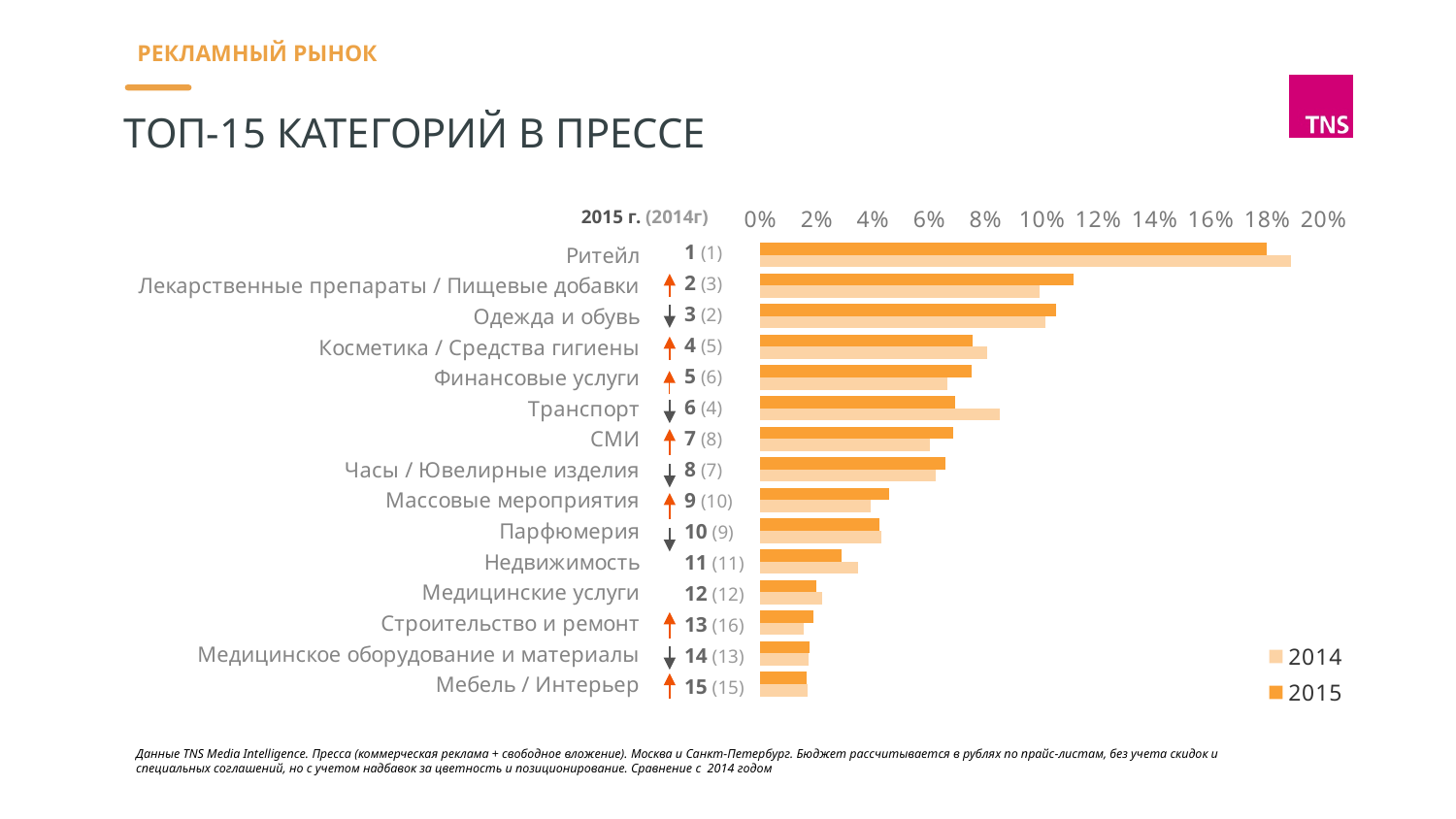
Is the 2014 value for Ритейл greater or less than 18%? greater Is the 2014 value for Транспорт greater or less than 8%? greater How many categories are shown in the chart? 15 What kind of chart is shown on the slide? bar chart For Транспорт, which year has the larger value, 2014 or 2015? 2014 How many series does the legend list? 2 What is the title of the chart? ТОП-15 КАТЕГОРИЙ В ПРЕССЕ Is the 2015 value for Недвижимость greater or less than 4%? less Which category has the highest value for 2015? Ритейл For Лекарственные препараты / Пищевые добавки, which year has the larger value, 2014 or 2015? 2015 What rank did Транспорт hold in 2014 according to the chart? 4